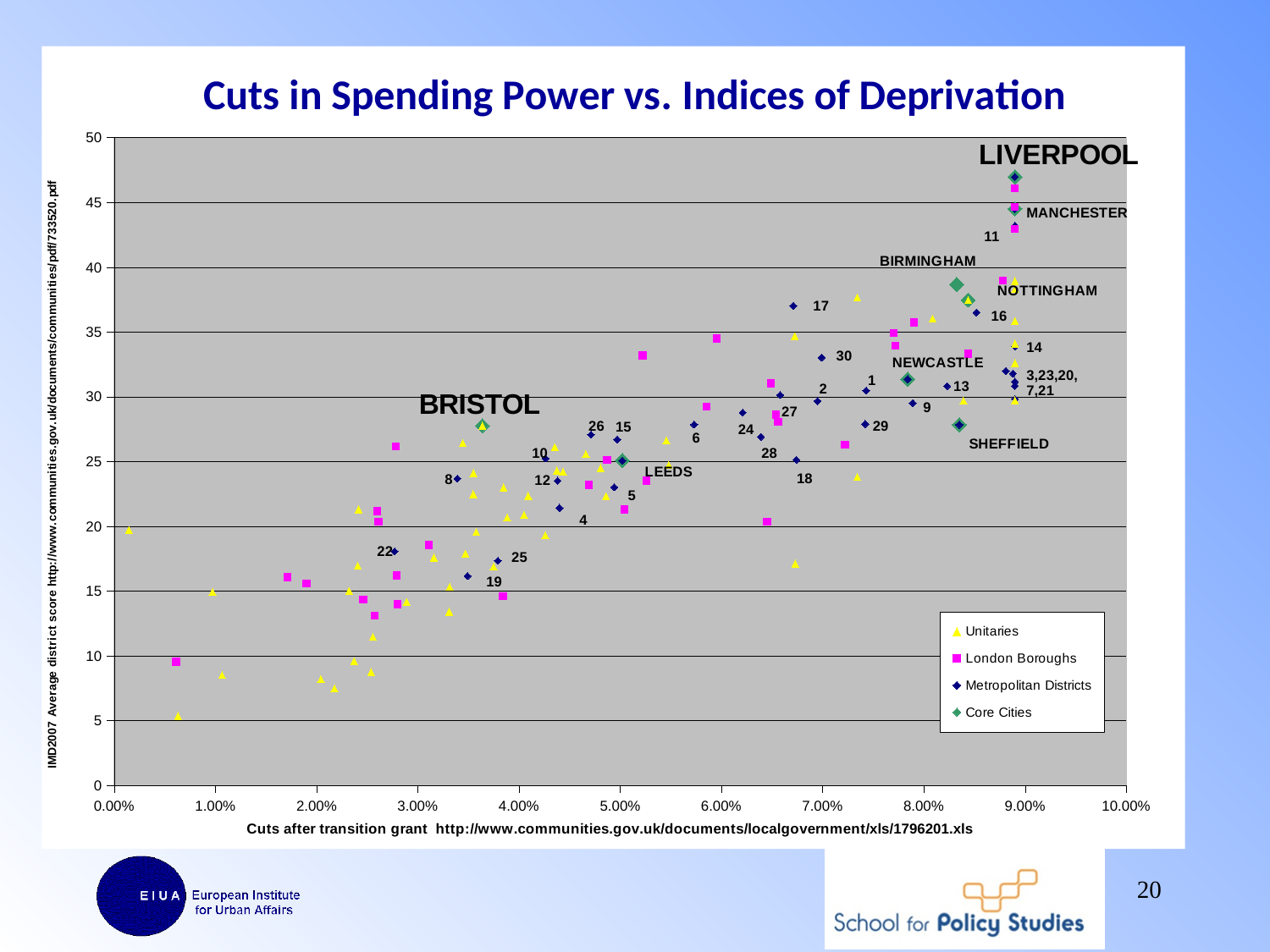
Is the cut after transition grant for Bristol greater or less than 4.00%? less How many series does the legend list? 4 Is the IMD2007 average district score for Manchester greater or less than 40? greater Is the IMD2007 average district score for Bristol greater or less than 30? less What kind of chart is shown on the slide? scatter chart Which series in the legend is shown with yellow triangle markers? Unitaries What is the title of the chart? Cuts in Spending Power vs. Indices of Deprivation Which labelled core city has the highest IMD2007 average district score? Liverpool Which has a higher IMD2007 average district score, Liverpool or Bristol? Liverpool Which labelled core city has the lowest IMD2007 average district score? Leeds As the cuts after transition grant increase along the x axis, do the IMD2007 average district scores generally rise or fall? rise